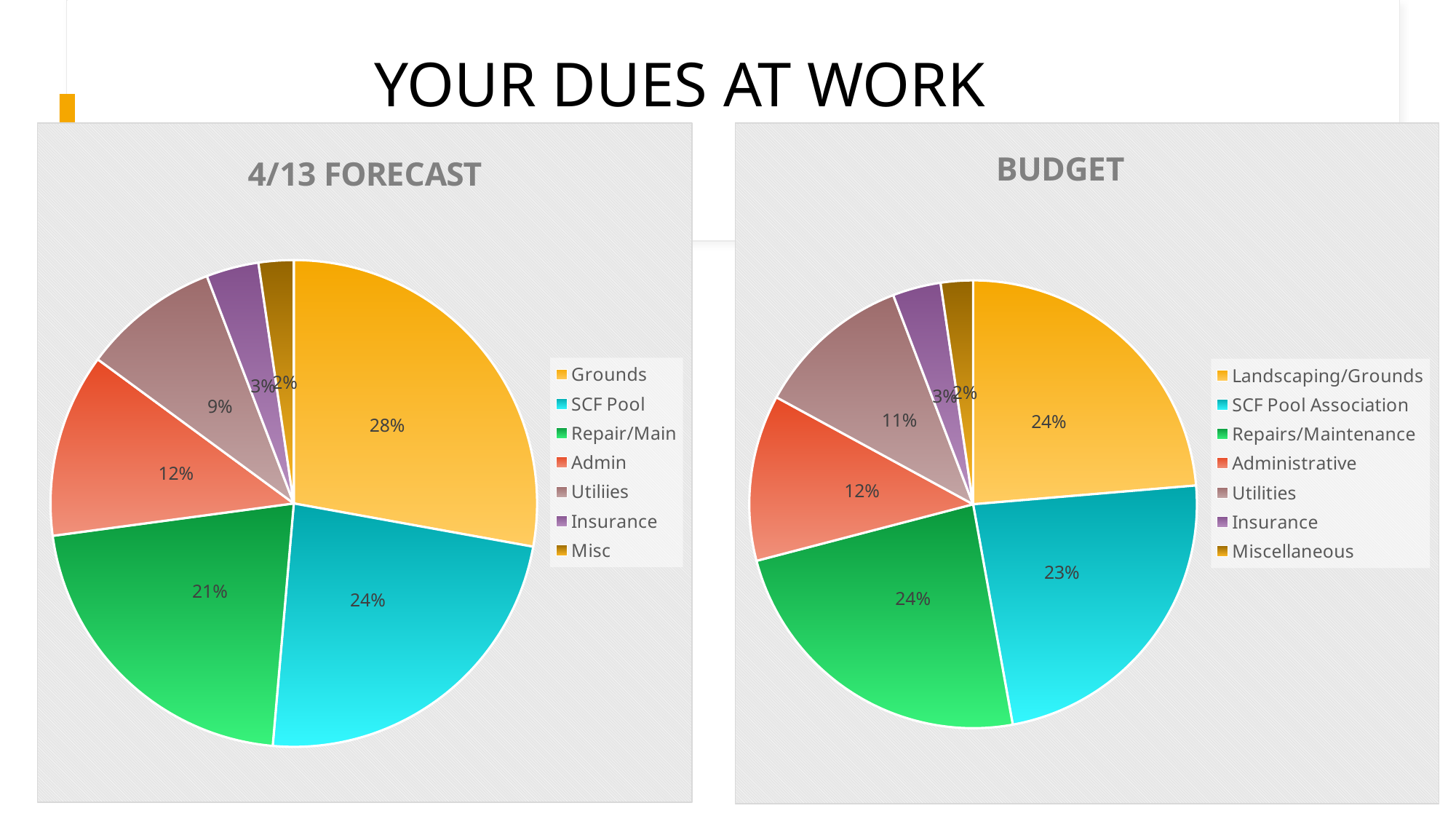
In the BUDGET chart, what share does Utilities have? 11% In the BUDGET chart, which category has the smallest share? Miscellaneous In the BUDGET chart, what share does SCF Pool Association have? 23% In the 4/13 FORECAST chart, what is the difference between the Grounds share and the Repair/Main share? 7% In the 4/13 FORECAST chart, which category has the largest share? Grounds In the 4/13 FORECAST chart, what share does SCF Pool have? 24% In the 4/13 FORECAST chart, which category has the smallest share? Misc In the BUDGET chart, what colour is the Insurance slice? Purple In the 4/13 FORECAST chart, how many categories does the legend list? 7 In the 4/13 FORECAST chart, what share does Grounds have? 28% What kind of chart is the BUDGET chart? Pie chart In the BUDGET chart, which is larger, the Administrative share or the Utilities share? Administrative